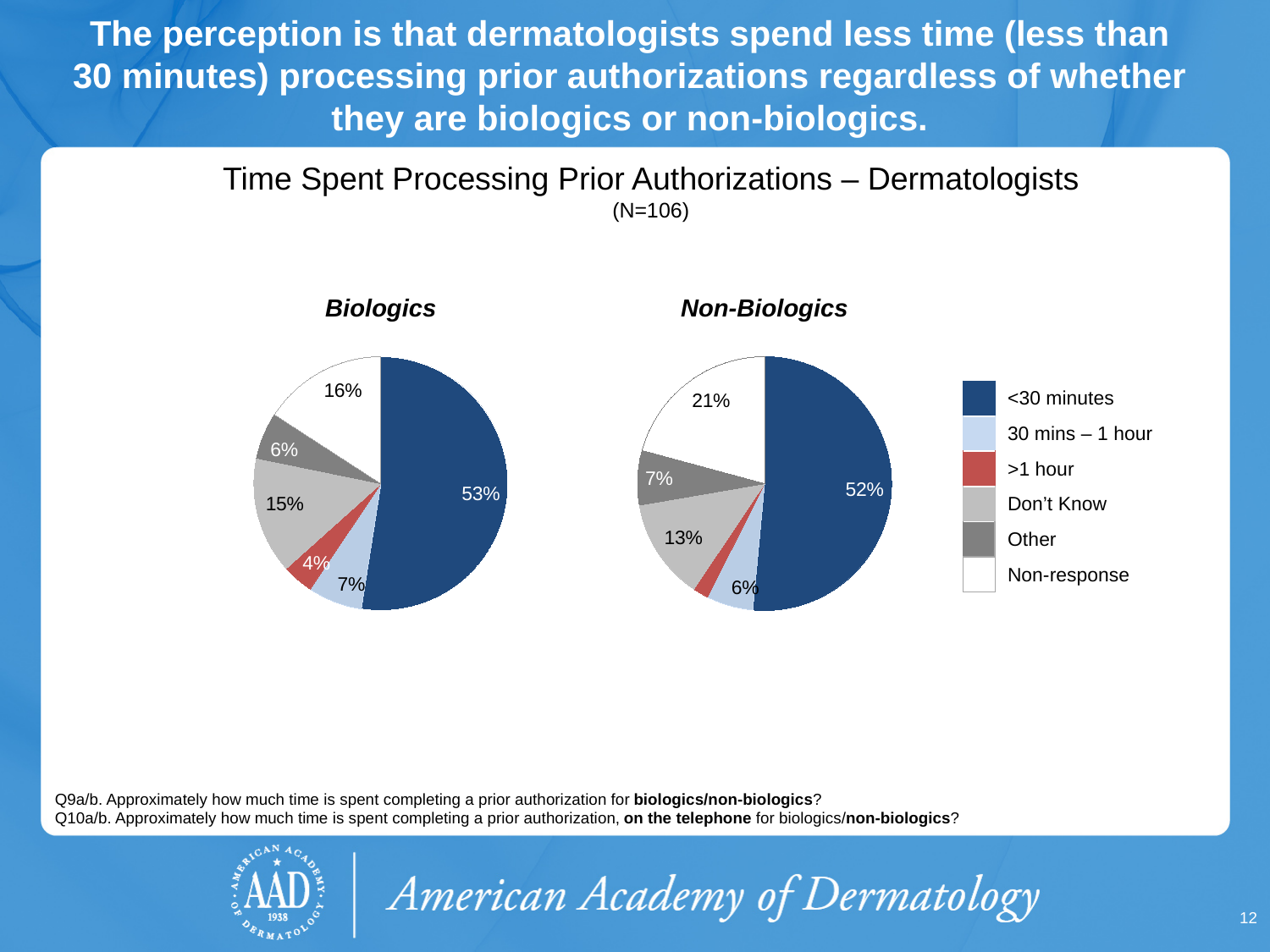
In the Biologics pie chart, what is the Non-response share? 16% In the Biologics pie chart, which labeled category has the smallest share? >1 hour In the Biologics pie chart, what share is >1 hour? 4% In the Non-Biologics pie chart, what is the Don't Know share? 13% In the Biologics pie chart, what share of dermatologists reported spending <30 minutes? 53% Which is larger: the Don't Know share in the Biologics chart or the Don't Know share in the Non-Biologics chart? Biologics What type of chart is used to show Time Spent Processing Prior Authorizations? Pie chart In the Non-Biologics pie chart, what share of dermatologists reported spending <30 minutes? 52% In the Biologics pie chart, which category has the largest share? <30 minutes How many categories does the legend list for the pie charts? 6 What is the sample size (N) shown under the chart title? N=106 What is the difference between the Non-response share in the Non-Biologics chart and the Non-response share in the Biologics chart? 5%